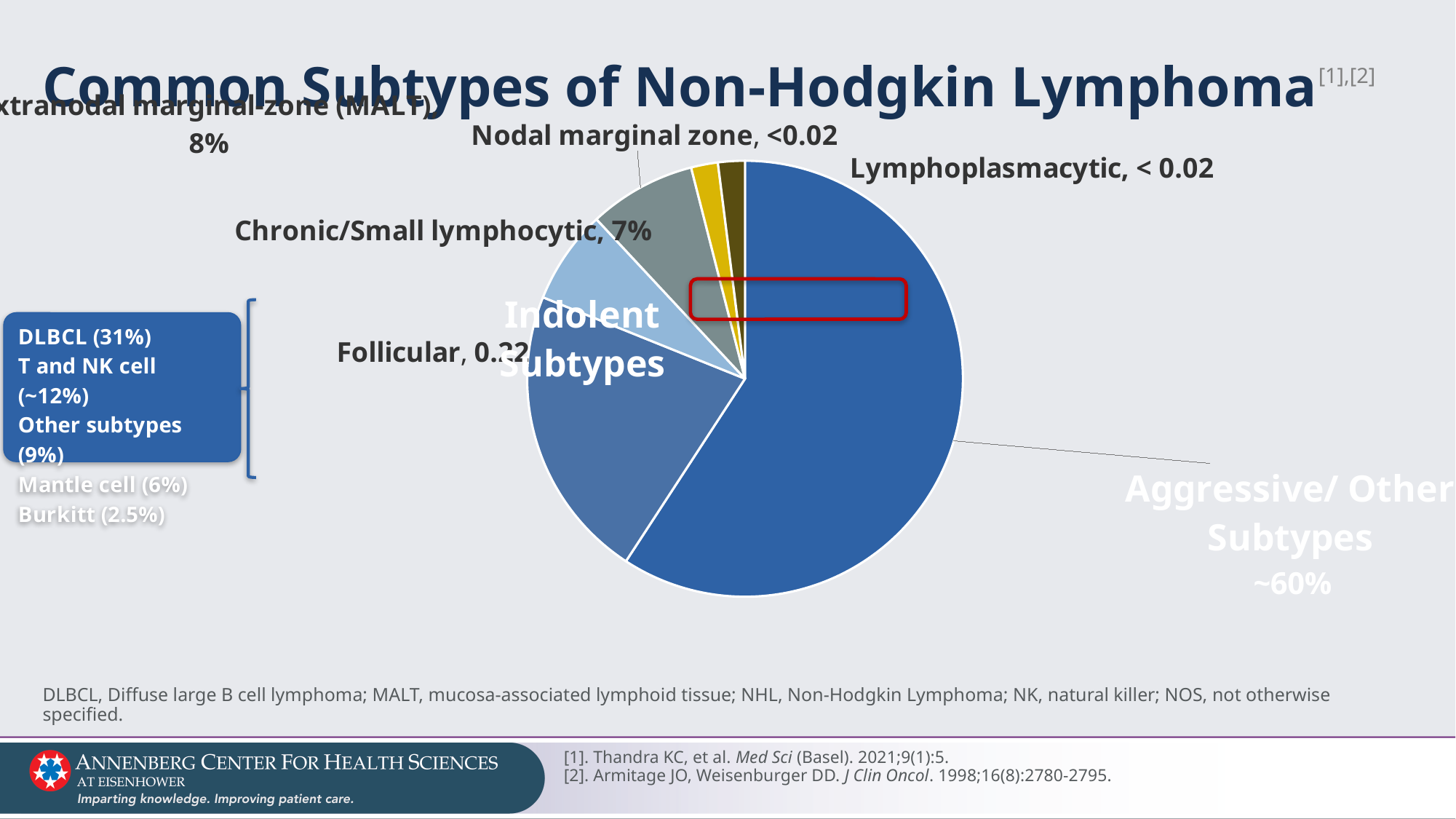
What label is written over the left part of the pie chart? Indolent Subtypes What is the title of the slide? Common Subtypes of Non-Hodgkin Lymphoma How many slices does the pie chart have? 6 What type of chart is shown on the slide? pie chart Which is larger, the Extranodal marginal-zone (MALT) slice or the Chronic/Small lymphocytic slice? Extranodal marginal-zone (MALT) What percentage is shown for Extranodal marginal-zone (MALT)? 8% Which is larger, the Follicular slice or the Chronic/Small lymphocytic slice? Follicular What is the difference between the Extranodal marginal-zone (MALT) percentage and the Chronic/Small lymphocytic percentage? 1% What value is labelled for Aggressive/ Other Subtypes? ~60% Which subtype has the largest slice of the pie? Aggressive/ Other Subtypes What percentage is shown for Chronic/Small lymphocytic? 7%